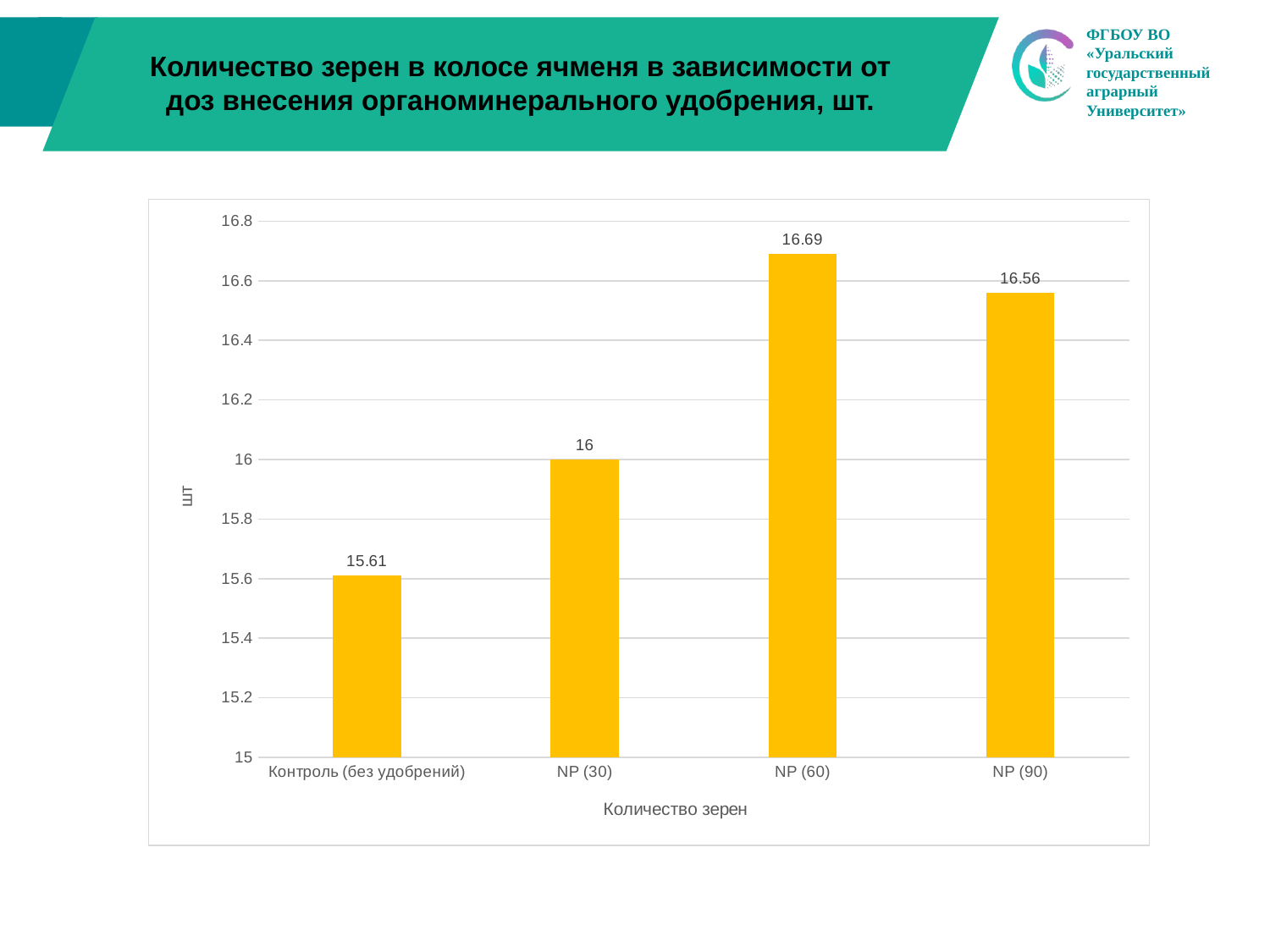
What is the difference between the values for NP (60) and NP (90)? 0.13 What is the difference between the values for NP (60) and Контроль (без удобрений)? 1.08 Which category has the highest value? NP (60) What is the label of the x axis? Количество зерен How many categories are shown on the x axis? 4 Which is larger, the value for NP (30) or the value for NP (90)? NP (90) What is the value for NP (60)? 16.69 Which category has the lowest value? Контроль (без удобрений) What kind of chart is shown on the slide? bar chart What is the value for Контроль (без удобрений)? 15.61 Is the value for NP (30) greater or less than 15.8? greater What is the value for NP (90)? 16.56